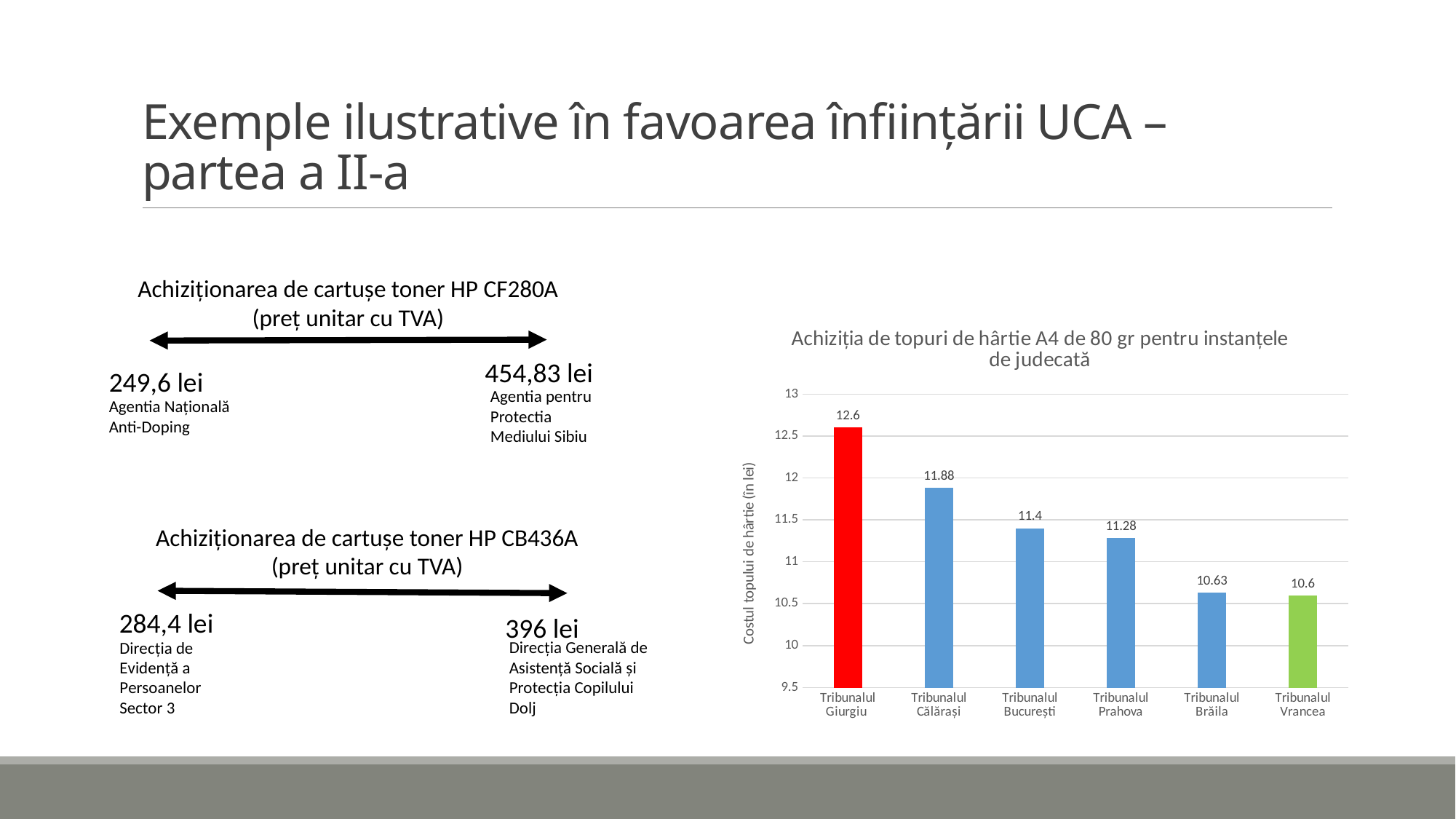
What is the value for Tribunalul Brăila? 10.63 Which court has the highest value in the chart? Tribunalul Giurgiu Which is larger, the value for Tribunalul București or the value for Tribunalul Brăila? Tribunalul București What is the title of the chart on the slide? Achiziția de topuri de hârtie A4 de 80 gr pentru instanțele de judecată Do the values generally rise or fall from left to right across the chart? fall What is the value for Tribunalul Giurgiu? 12.6 What is the difference between the values for Tribunalul Călărași and Tribunalul București? 0.48 How many courts (categories) are shown in the chart? 6 What is the value for Tribunalul Prahova? 11.28 What is the difference between the values for Tribunalul Giurgiu and Tribunalul Vrancea? 2 What type of chart is shown on the slide? bar chart What is the value for Tribunalul Călărași? 11.88